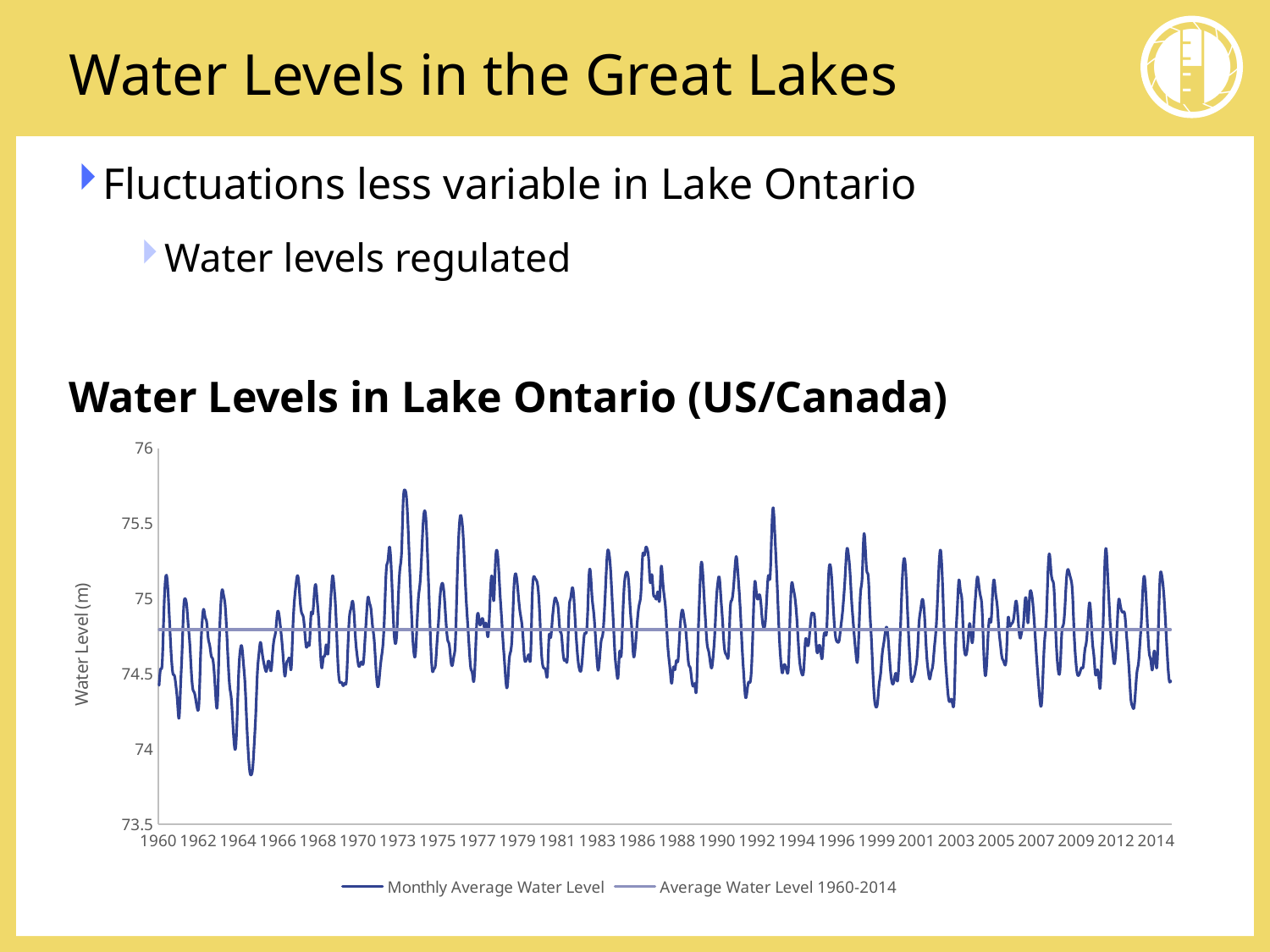
What kind of chart is shown on the slide? line chart Is the Average Water Level 1960-2014 line greater or less than 75? less What is the title of the chart? Water Levels in Lake Ontario (US/Canada) Is the lowest point of the Monthly Average Water Level series greater or less than 74? less Around which labelled year does the Monthly Average Water Level reach its highest peak? 1973 What is the first year shown on the horizontal axis? 1960 What is the last year shown on the horizontal axis? 2014 How many series does the legend list? 2 Is the highest peak of the Monthly Average Water Level series greater or less than 75.5? greater What is the label on the vertical axis of the chart? Water Level (m) What is the highest value shown on the vertical axis? 76